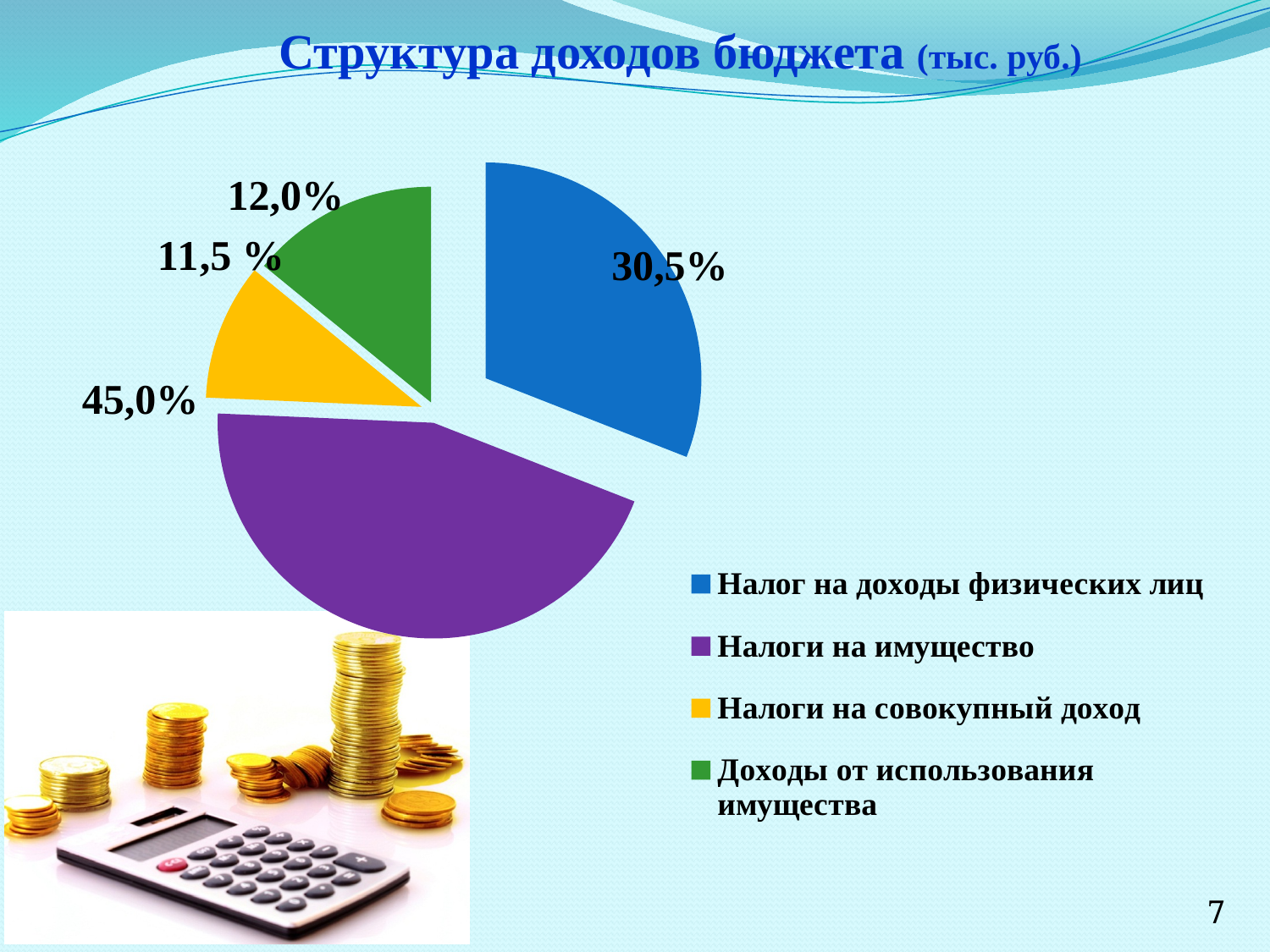
What is the title of the chart? Структура доходов бюджета (тыс. руб.) Which colour represents Налоги на совокупный доход in the legend? yellow What is the share for Налоги на совокупный доход? 11,5 % What is the share for Доходы от использования имущества? 12,0% Which is larger: the share for Налог на доходы физических лиц or the share for Доходы от использования имущества? Налог на доходы физических лиц What is the share for Налог на доходы физических лиц? 30,5% What kind of chart is shown on the slide? pie chart What is the difference between the shares of Налоги на имущество and Налог на доходы физических лиц? 14,5% Which category has the largest slice of the pie? Налоги на имущество What is the share for Налоги на имущество? 45,0% How many slices does the pie chart have? 4 Which category has the smallest slice of the pie? Налоги на совокупный доход